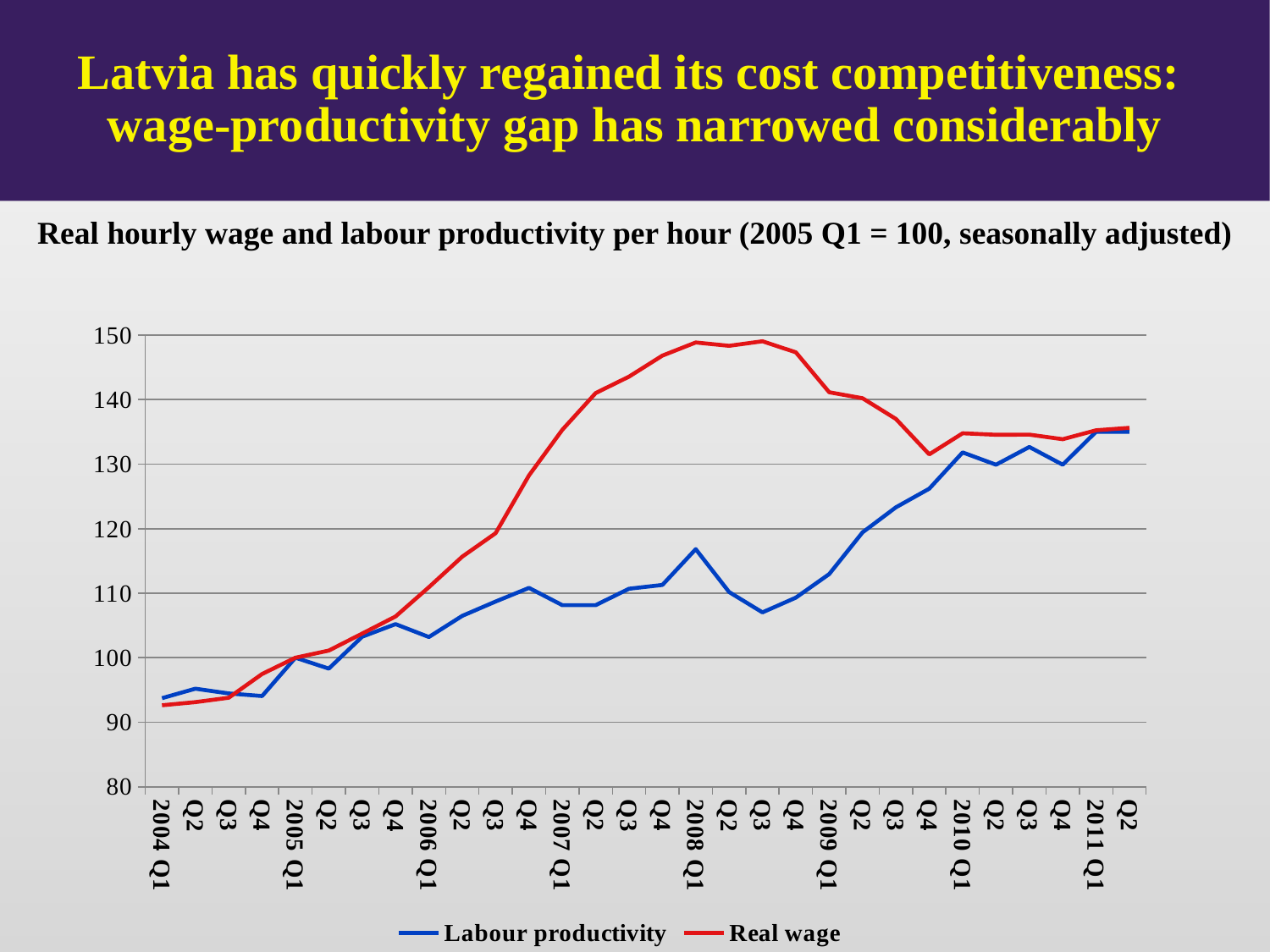
How many series does the legend list? 2 What colour is the Real wage line? red In which quarter is the Real wage series at its lowest? 2004 Q1 What kind of chart is shown on the slide? line chart Is the Labour productivity value for 2008 Q3 greater or less than 110? less Is the Labour productivity value for 2006 Q1 greater or less than 100? greater Is the Real wage value for 2007 Q1 greater or less than 130? greater Does the Real wage series rise or fall between 2008 Q3 and 2009 Q4? fall Which two series are listed in the legend? Labour productivity and Real wage In 2008 Q1, which series has the higher value, Labour productivity or Real wage? Real wage How many quarterly points are plotted along the x axis, from 2004 Q1 to 2011 Q2? 30